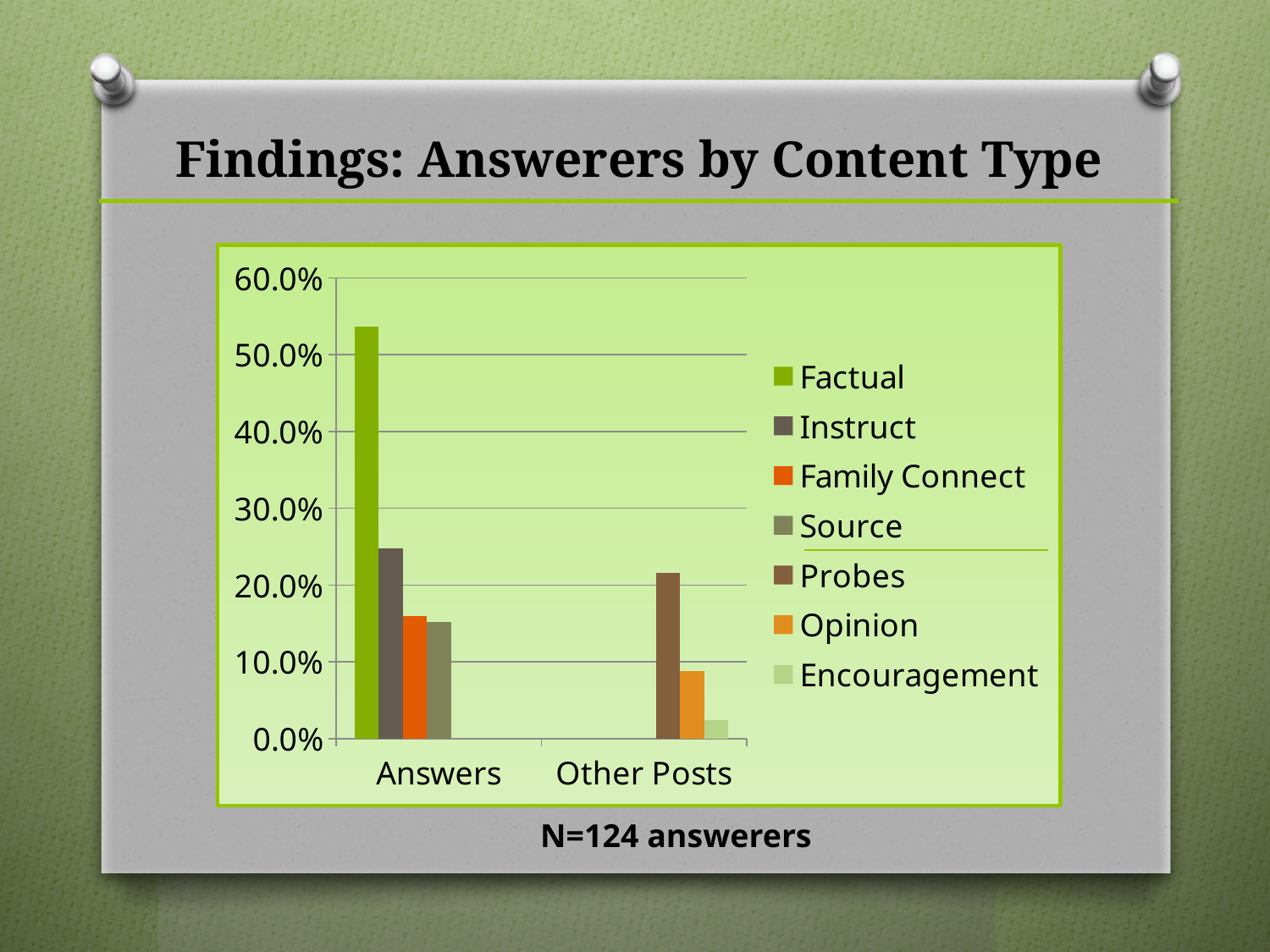
What kind of chart is shown on the slide? bar chart How many categories are shown on the x axis? 2 Is the value for Opinion in the Other Posts category greater or less than 10%? less What is the title of the slide? Findings: Answerers by Content Type Is the value for Probes in the Other Posts category greater or less than 30%? less Which is larger, the value for Factual in Answers or the value for Probes in Other Posts? Factual in Answers Is the value for Instruct in the Answers category greater or less than 30%? less How many series does the legend list? 7 Which is larger, the value for Opinion or the value for Encouragement in the Other Posts category? Opinion Which series has the highest value in the Answers category? Factual Which series has the lowest value in the Other Posts category? Encouragement